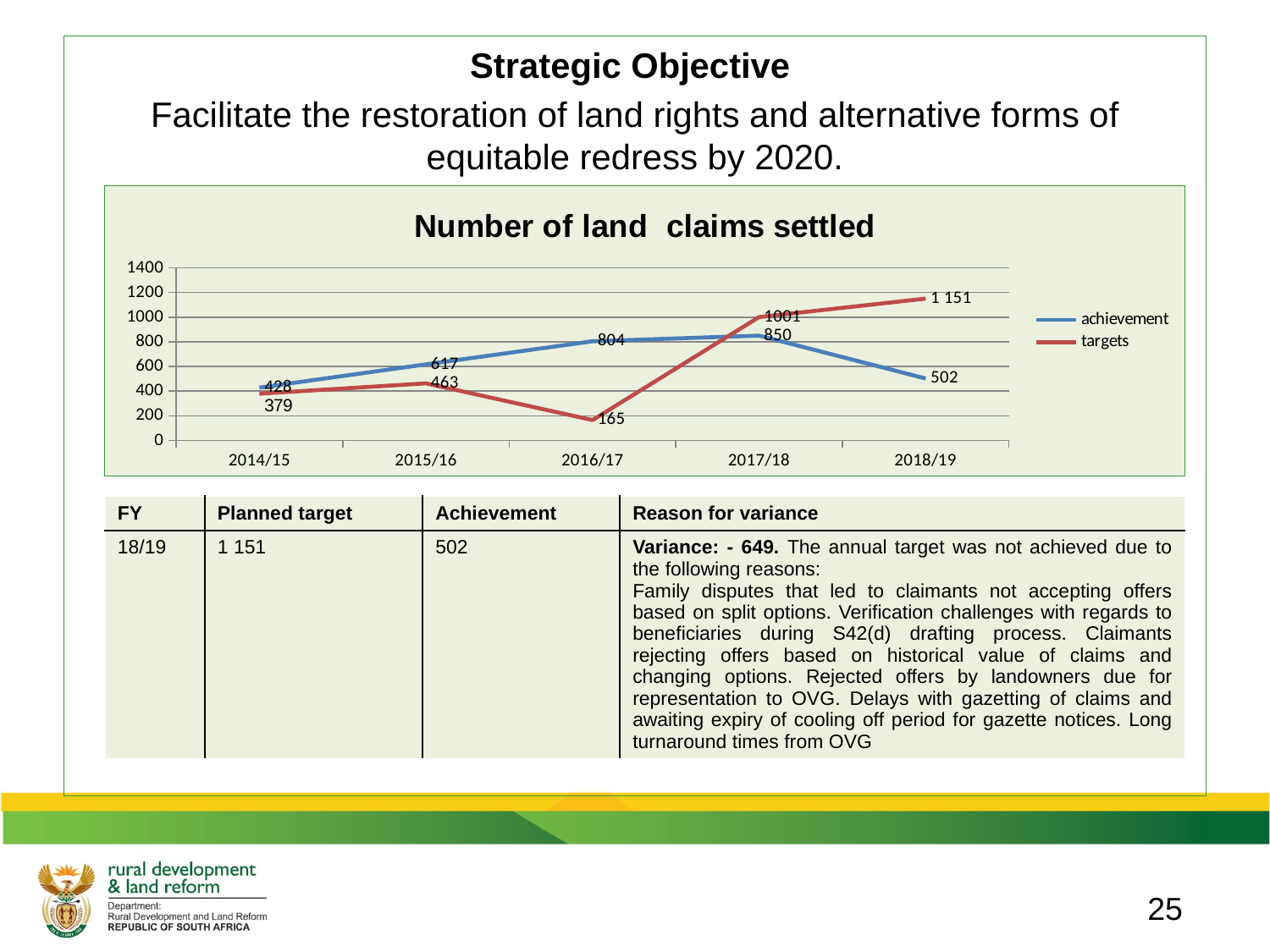
How many financial years are shown on the x axis? 5 In which financial year is the targets value lowest? 2016/17 What is the title of the chart? Number of land claims settled How many series does the legend list? 2 What is the targets value for 2018/19? 1 151 What kind of chart is shown on the slide? line chart In 2017/18, which is larger: achievement or targets? targets In which financial year is the achievement value highest? 2017/18 Do the targets values rise or fall from 2016/17 to 2018/19? rise What is the difference between the targets value and the achievement value in 2018/19? 649 What is the achievement value for 2016/17? 804 Is the achievement value for 2017/18 greater or less than 1000? less